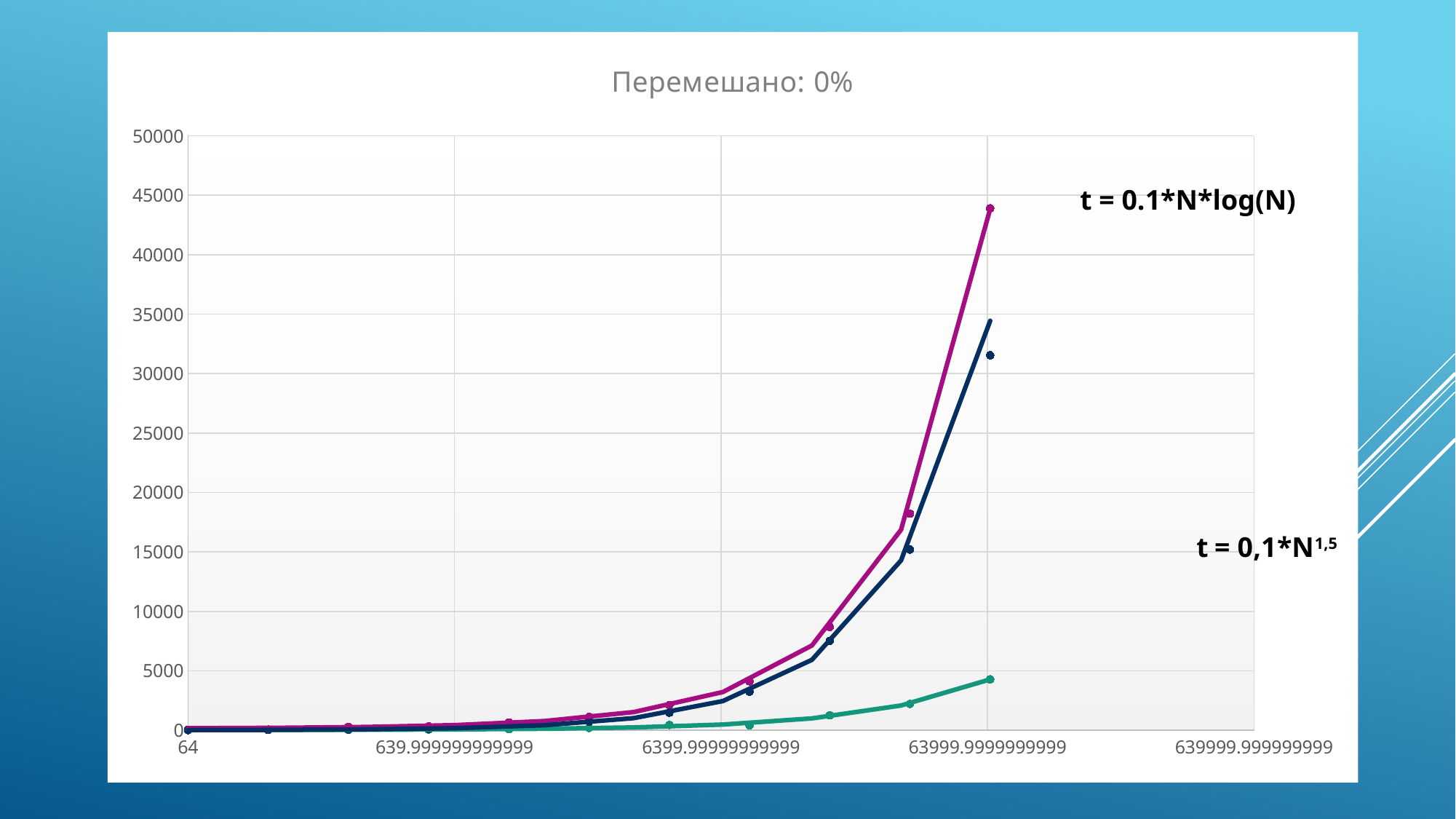
What kind of chart is shown on the slide? line chart Which line has the lowest values at the right end of the chart: the magenta, the dark blue, or the green one? green Do the values of the lines rise or fall as x increases along the x axis? rise Is the value of the magenta line at its last point (x = 63999.9999999999) greater or less than 40000? greater At the right end of the chart, is the dark blue line above or below the green line? above What is the first (leftmost) label on the x axis? 64 What is the title of the chart? Перемешано: 0% What is the highest value labelled on the y axis? 50000 Is the value of the dark blue line at its last point (x = 63999.9999999999) greater or less than 40000? less How many lines (series) are plotted on the chart? 3 Is the value of the green line at its last point (x = 63999.9999999999) greater or less than 5000? less Which line reaches the highest value at the right end of the chart: the magenta, the dark blue, or the green one? magenta